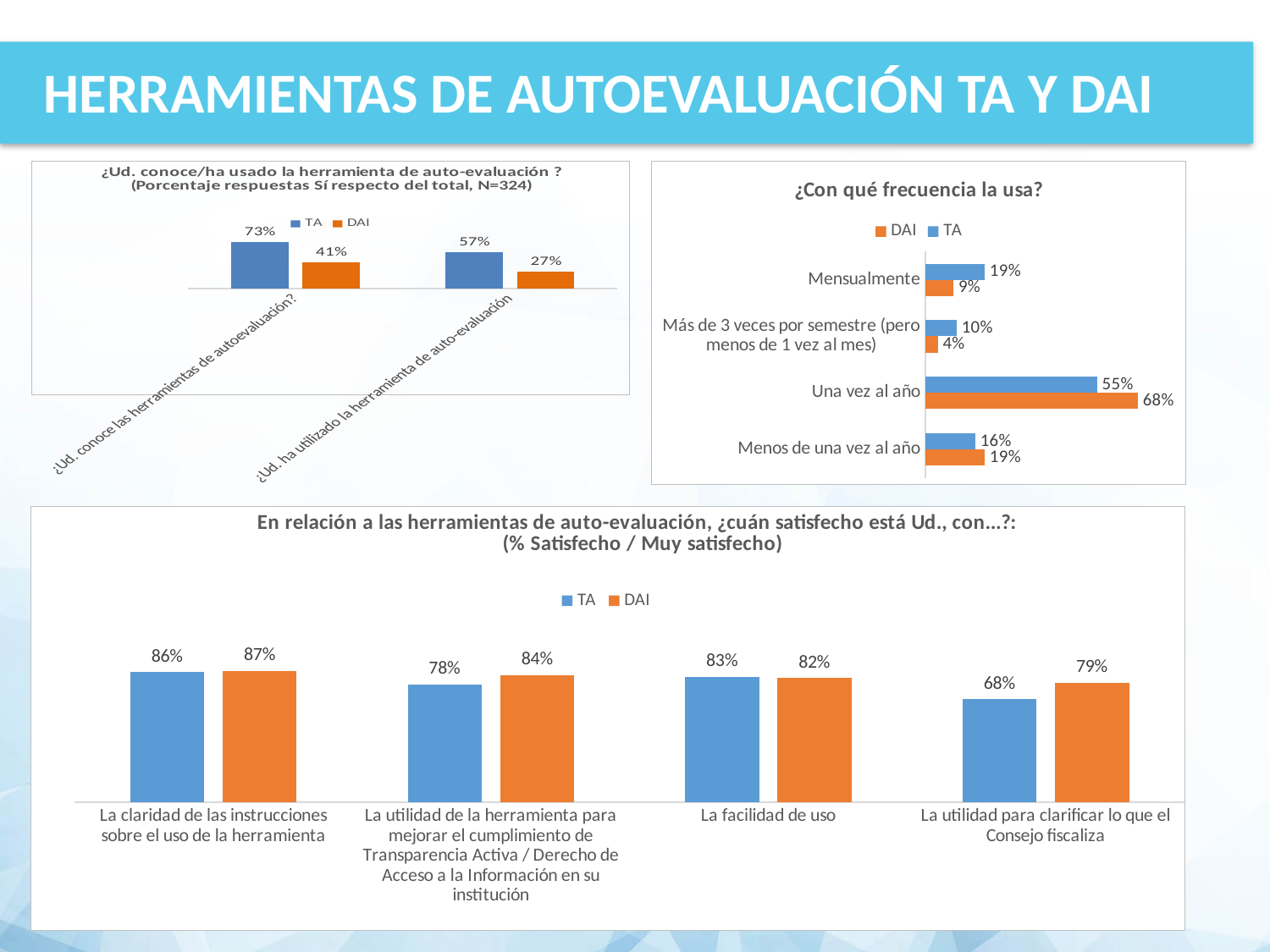
In the top-right chart '¿Con qué frecuencia la usa?', which category has the lowest DAI value? Más de 3 veces por semestre (pero menos de 1 vez al mes) In the top-right chart '¿Con qué frecuencia la usa?', what is the TA value for 'Mensualmente'? 19% In the bottom chart on satisfaction with the auto-evaluation tools, which is larger for 'La facilidad de uso': TA or DAI? TA In the top-left chart '¿Ud. conoce/ha usado la herramienta de auto-evaluación?', what is the DAI value for '¿Ud. ha utilizado la herramienta de auto-evaluación'? 27% In the bottom chart on satisfaction with the auto-evaluation tools, how many series does the legend list? 2 In the bottom chart on satisfaction with the auto-evaluation tools, what is the TA value for 'La utilidad para clarificar lo que el Consejo fiscaliza'? 68% In the top-left chart '¿Ud. conoce/ha usado la herramienta de auto-evaluación?', what is the difference between the TA and DAI values for '¿Ud. conoce las herramientas de autoevaluación?'? 32% In the top-right chart '¿Con qué frecuencia la usa?', how many categories are shown? 4 In the top-left chart '¿Ud. conoce/ha usado la herramienta de auto-evaluación?', what is the TA value for '¿Ud. conoce las herramientas de autoevaluación?'? 73% In the top-right chart '¿Con qué frecuencia la usa?', what is the DAI value for 'Una vez al año'? 68% In the top-right chart '¿Con qué frecuencia la usa?', which category has the highest TA value? Una vez al año In the bottom chart on satisfaction with the auto-evaluation tools, what is the DAI value for 'La utilidad de la herramienta para mejorar el cumplimiento de Transparencia Activa / Derecho de Acceso a la Información en su institución'? 84%